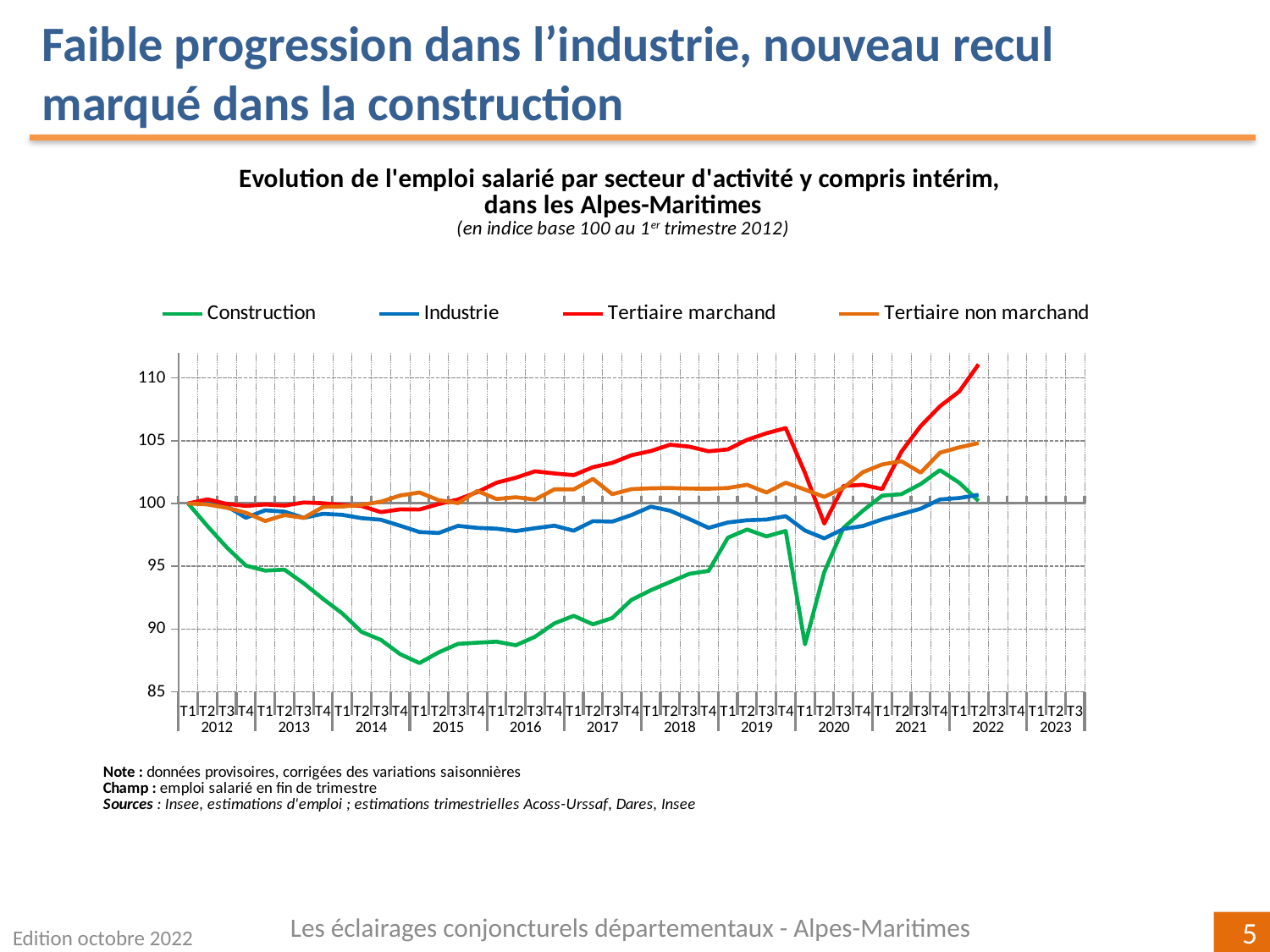
What is the index value of all series at T1 2012, the base quarter? 100 At T1 2020, which is larger: the value for Industrie or the value for Construction? Industrie Is the value for Industrie at T1 2015 greater or less than 100? less Is the value for Construction at T1 2014 greater or less than 95? less What kind of chart is shown on the slide? line chart Is the value for Construction at T1 2015 greater or less than 90? less Does the Construction series rise or fall between T1 2012 and T1 2015? fall Which series is shown in green in the legend? Construction How many series does the legend list? 4 Which series has the lowest value at T1 2015? Construction Which series has the highest value at T2 2022? Tertiaire marchand